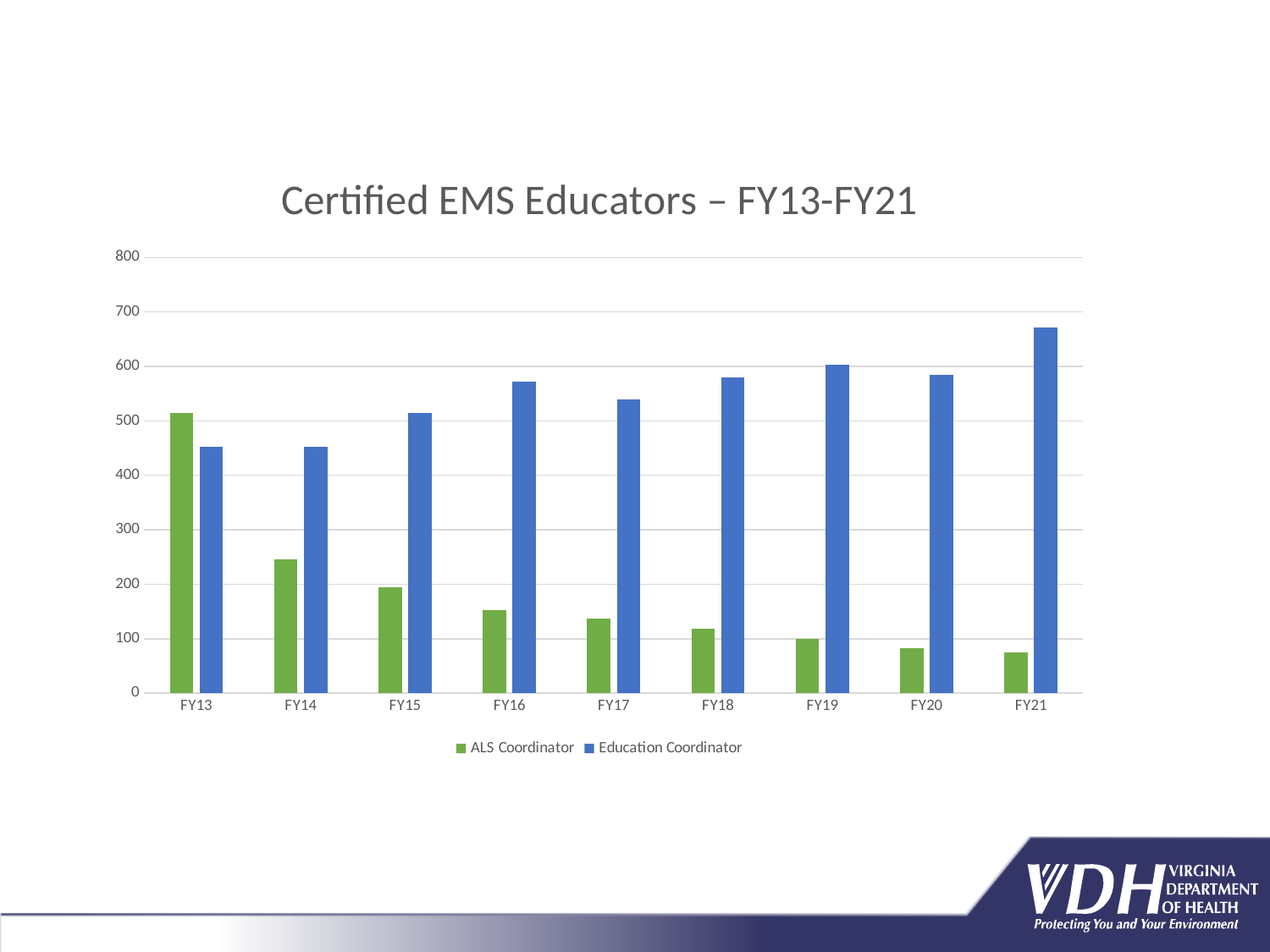
Which fiscal year has the highest value for Education Coordinator? FY21 In FY13, which series has the larger value, ALS Coordinator or Education Coordinator? ALS Coordinator How many series does the legend list? 2 Which fiscal year has the highest value for ALS Coordinator? FY13 Is the value for Education Coordinator in FY13 greater or less than 500? less What is the title of the chart? Certified EMS Educators – FY13-FY21 Do the ALS Coordinator values rise or fall from FY13 to FY21? fall Is the value for ALS Coordinator in FY21 greater or less than 100? less How many fiscal years are shown on the x axis? 9 Is the value for ALS Coordinator in FY14 greater or less than 200? greater What kind of chart is shown on the slide? bar chart